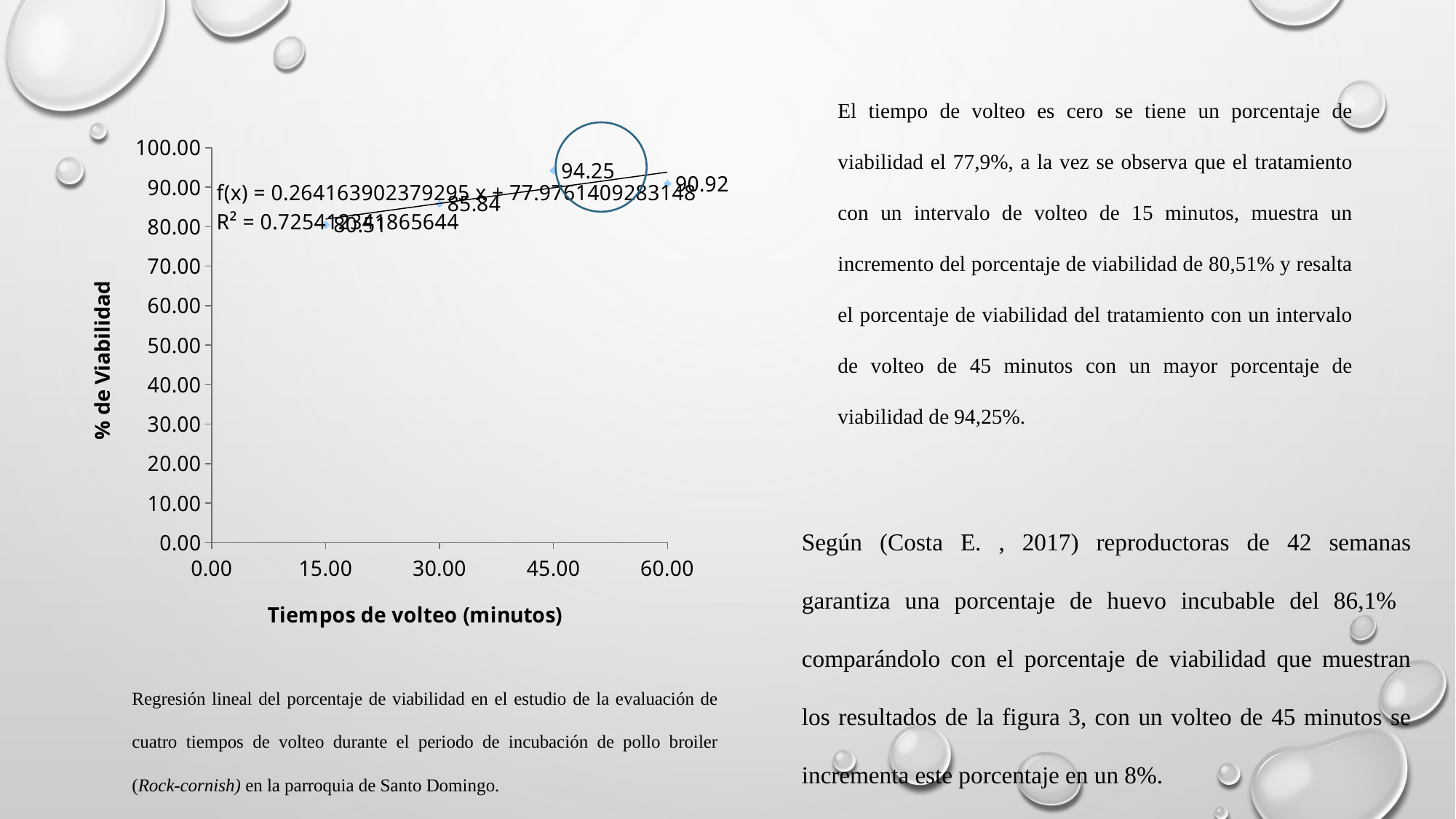
How many data points are plotted on the chart? 4 At which volteo time is the % de Viabilidad lowest? 15.00 What is the label of the x axis of the chart? Tiempos de volteo (minutos) What is the % de Viabilidad value at a volteo time of 60.00 minutes? 90.92 Which has a higher % de Viabilidad: 45.00 minutes or 60.00 minutes? 45.00 minutes What is the difference between the % de Viabilidad at 45.00 minutes and at 15.00 minutes? 13.74 What kind of chart is shown on the slide? Scatter chart What is the % de Viabilidad value at a volteo time of 30.00 minutes? 85.84 What is the % de Viabilidad value at a volteo time of 45.00 minutes? 94.25 What is the % de Viabilidad value at a volteo time of 15.00 minutes? 80.51 Is the % de Viabilidad at 30.00 minutes greater or less than 80.00? greater At which volteo time is the % de Viabilidad highest? 45.00